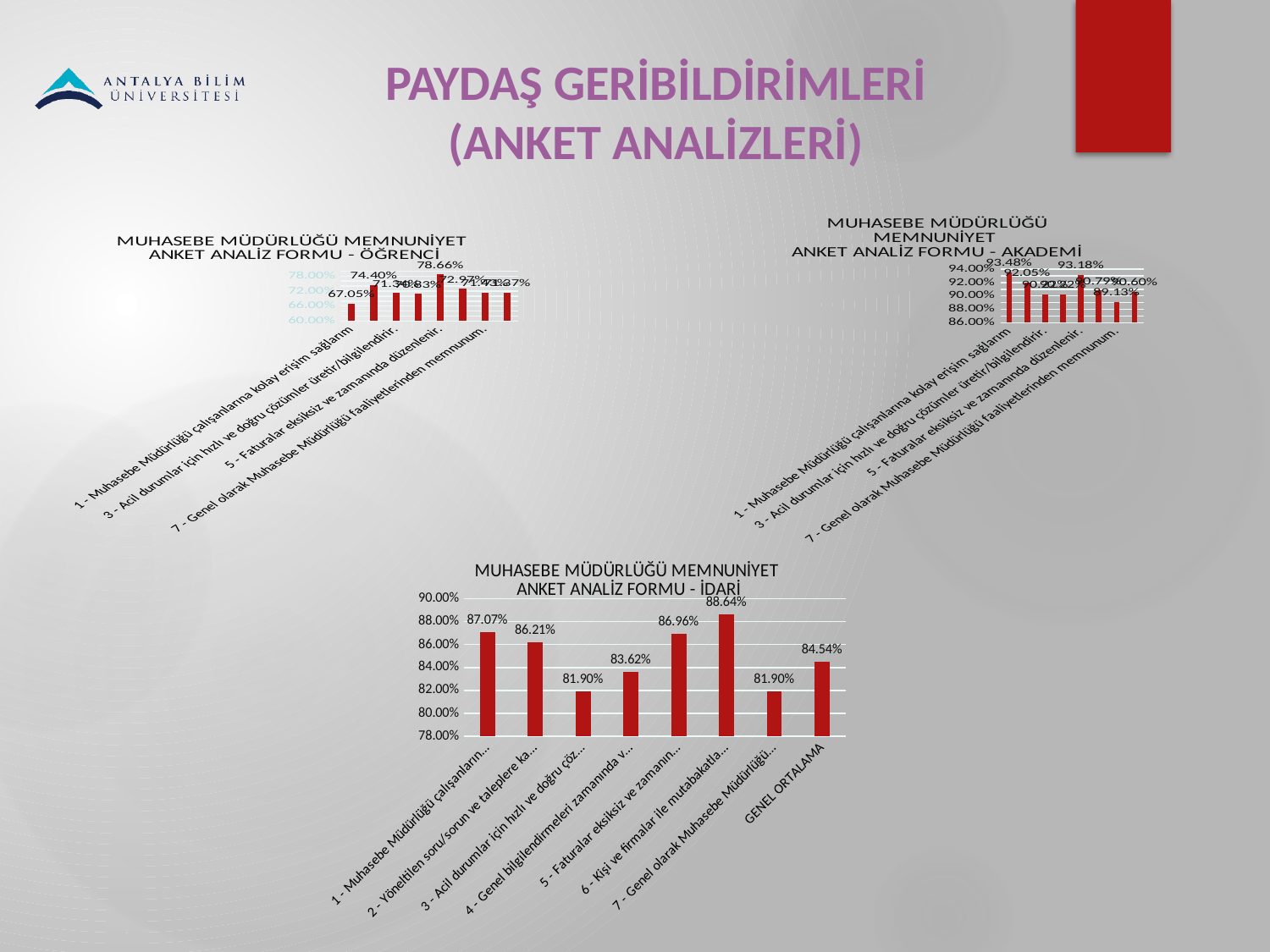
In the AKADEMİ chart (top right), what is the highest value shown? 93.48% In the İDARİ chart (bottom), what is the difference between the values for category 1 (87.07%) and category 2 (86.21%)? 0.86% In the İDARİ chart (bottom), how many bars are plotted? 8 What type of chart is the İDARİ chart at the bottom of the slide? Bar chart In the ÖĞRENCİ chart (top left), what is the value of the first bar (1 - Muhasebe Müdürlüğü çalışanlarına kolay erişim sağlanır)? 67.05% In the ÖĞRENCİ chart (top left), what is the highest value shown? 78.66% In the İDARİ chart (bottom), which is larger: the value for category 4 or the value for category 5? Category 5 (86.96%) What is the title of the chart at the bottom of the slide? MUHASEBE MÜDÜRLÜĞÜ MEMNUNİYET ANKET ANALİZ FORMU - İDARİ In the İDARİ chart (bottom), what is the value for GENEL ORTALAMA? 84.54% In the İDARİ chart (bottom), what is the lowest value shown? 81.90% In the İDARİ chart (bottom), which category has the highest value? 6 - Kişi ve firmalar ile mutabakatla... In the İDARİ chart (bottom), what is the value for category 6 (Kişi ve firmalar ile mutabakatla...)? 88.64%